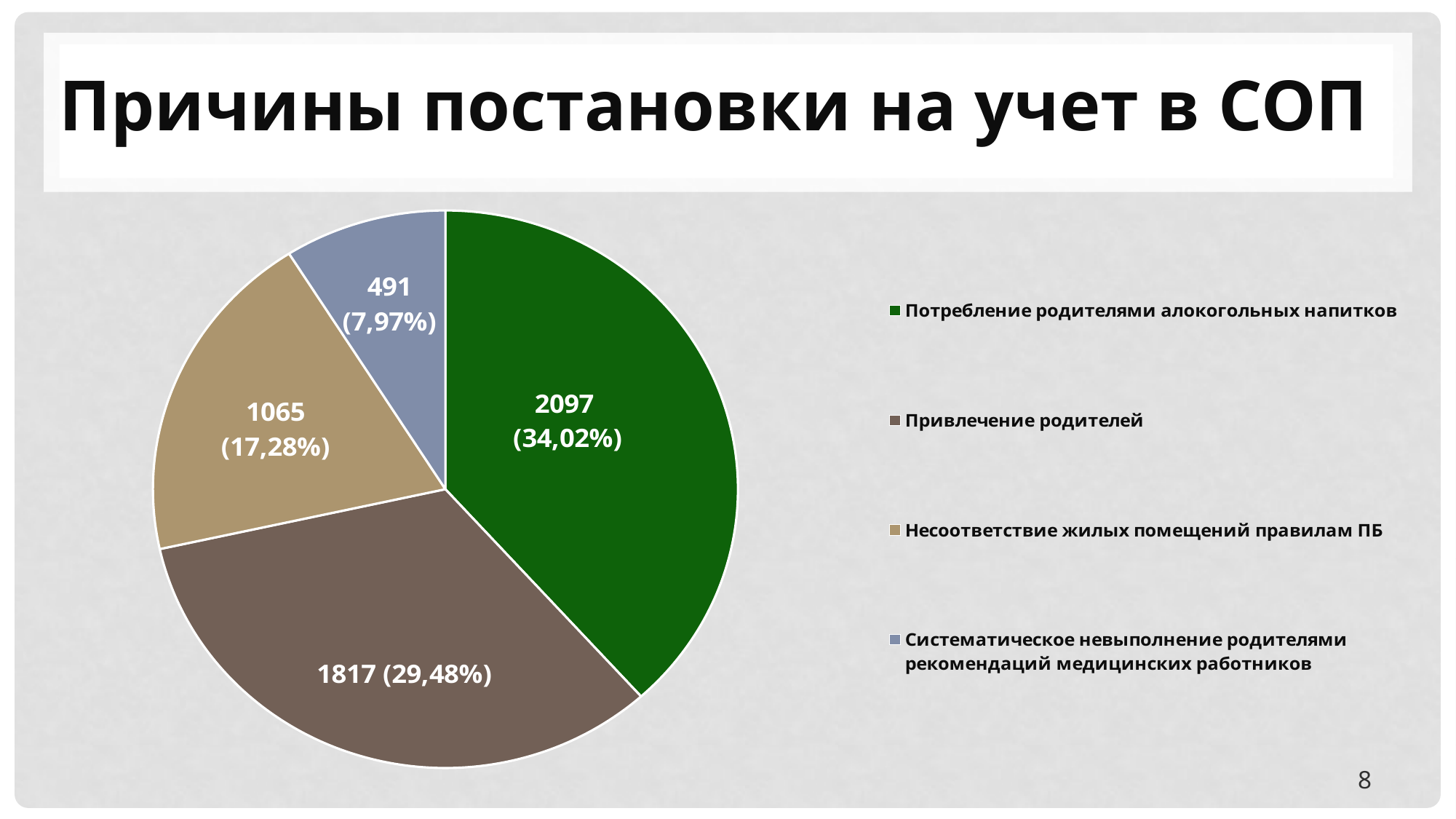
What percentage share is printed for the slice "Потребление родителями алокогольных напитков"? 34,02% What is the value shown for the slice "Потребление родителями алокогольных напитков"? 2097 Which is larger: the value for "Несоответствие жилых помещений правилам ПБ" or the value for "Систематическое невыполнение родителями рекомендаций медицинских работников"? Несоответствие жилых помещений правилам ПБ What is the value shown for the slice "Систематическое невыполнение родителями рекомендаций медицинских работников"? 491 What is the difference between the values for "Потребление родителями алокогольных напитков" and "Привлечение родителей"? 280 Which category has the largest slice of the pie? Потребление родителями алокогольных напитков How many categories does the legend list? 4 What is the value shown for the slice "Несоответствие жилых помещений правилам ПБ"? 1065 Which category has the smallest slice of the pie? Систематическое невыполнение родителями рекомендаций медицинских работников What percentage share is printed for the slice "Несоответствие жилых помещений правилам ПБ"? 17,28% What type of chart is shown on the slide? pie chart What is the value shown for the slice "Привлечение родителей"? 1817